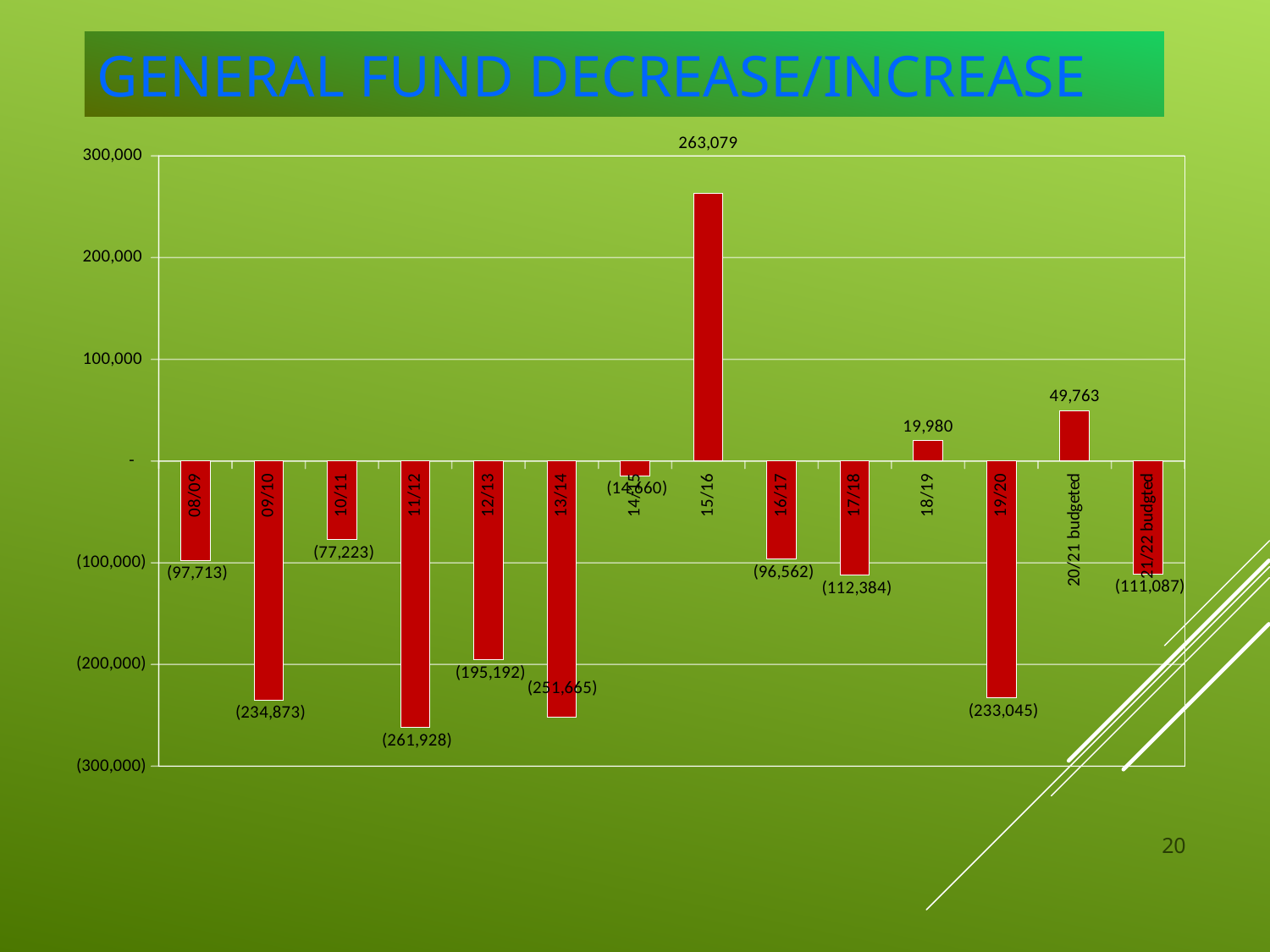
What is the difference between the values for 20/21 budgeted and 18/19? 29,783 Which year has the highest value? 15/16 What is the value for 15/16? 263,079 Is the value for 13/14 greater or less than (200,000)? less What is the value for 21/22 budgeted? (111,087) How many years are shown on the x axis? 14 Which is larger, the value for 18/19 or the value for 20/21 budgeted? 20/21 budgeted Which year has the lowest value? 11/12 What kind of chart is shown on the slide? bar chart What is the value for 10/11? (77,223) What is the value for 11/12? (261,928) How many years show a positive (increase) value? 3